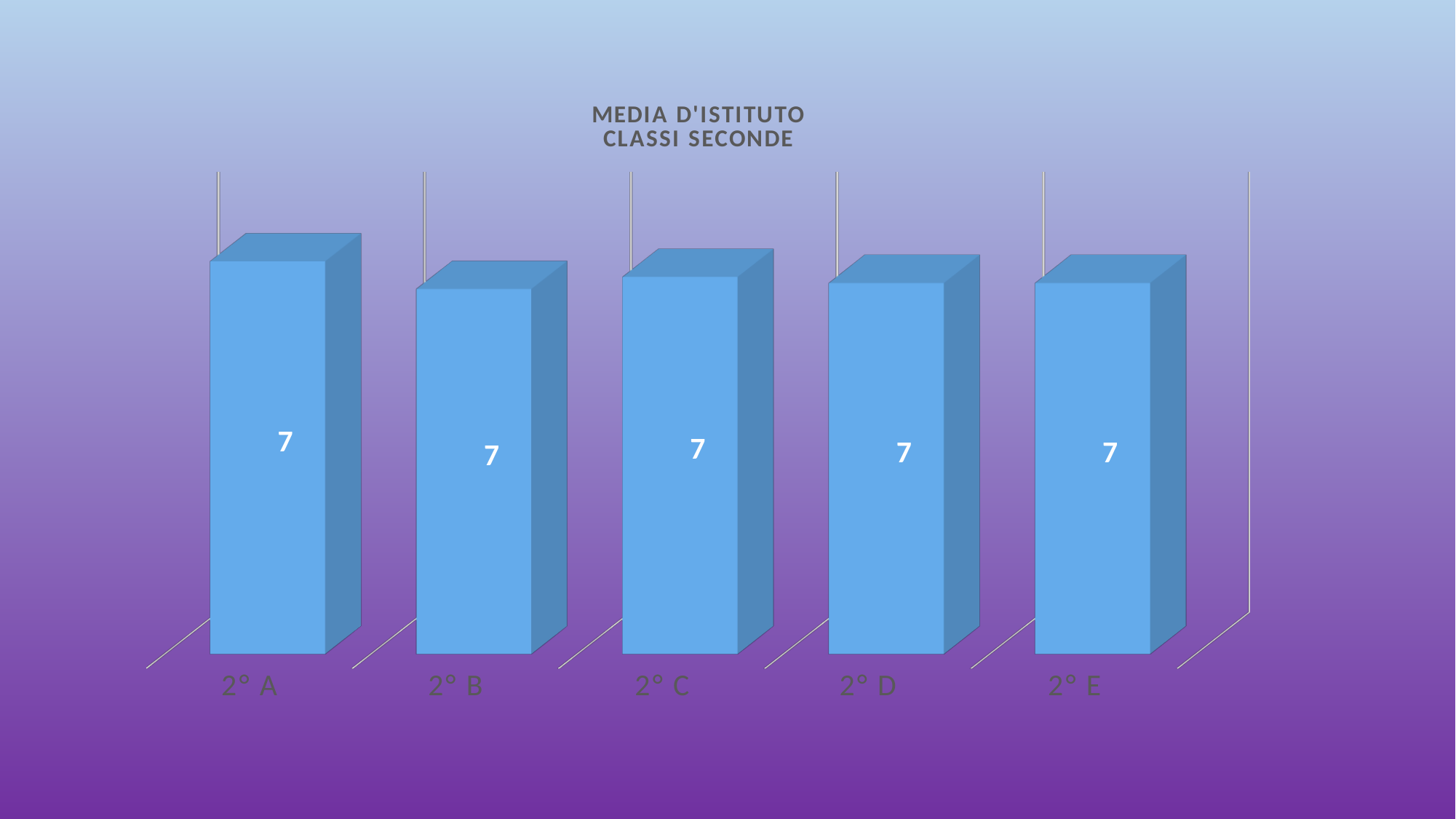
What colour are the bars in the chart? Blue What is the title of the chart? MEDIA D'ISTITUTO CLASSI SECONDE How many classes are shown on the chart? 5 What is the value for 2° A? 7 What is the value for 2° E? 7 What is the value for 2° C? 7 What is the value for 2° D? 7 What kind of chart is shown on the slide? Bar chart What is the difference between the values for 2° A and 2° E? 0 What is the value for 2° B? 7 Do the labelled values rise, fall or stay the same from 2° A to 2° E? Stay the same